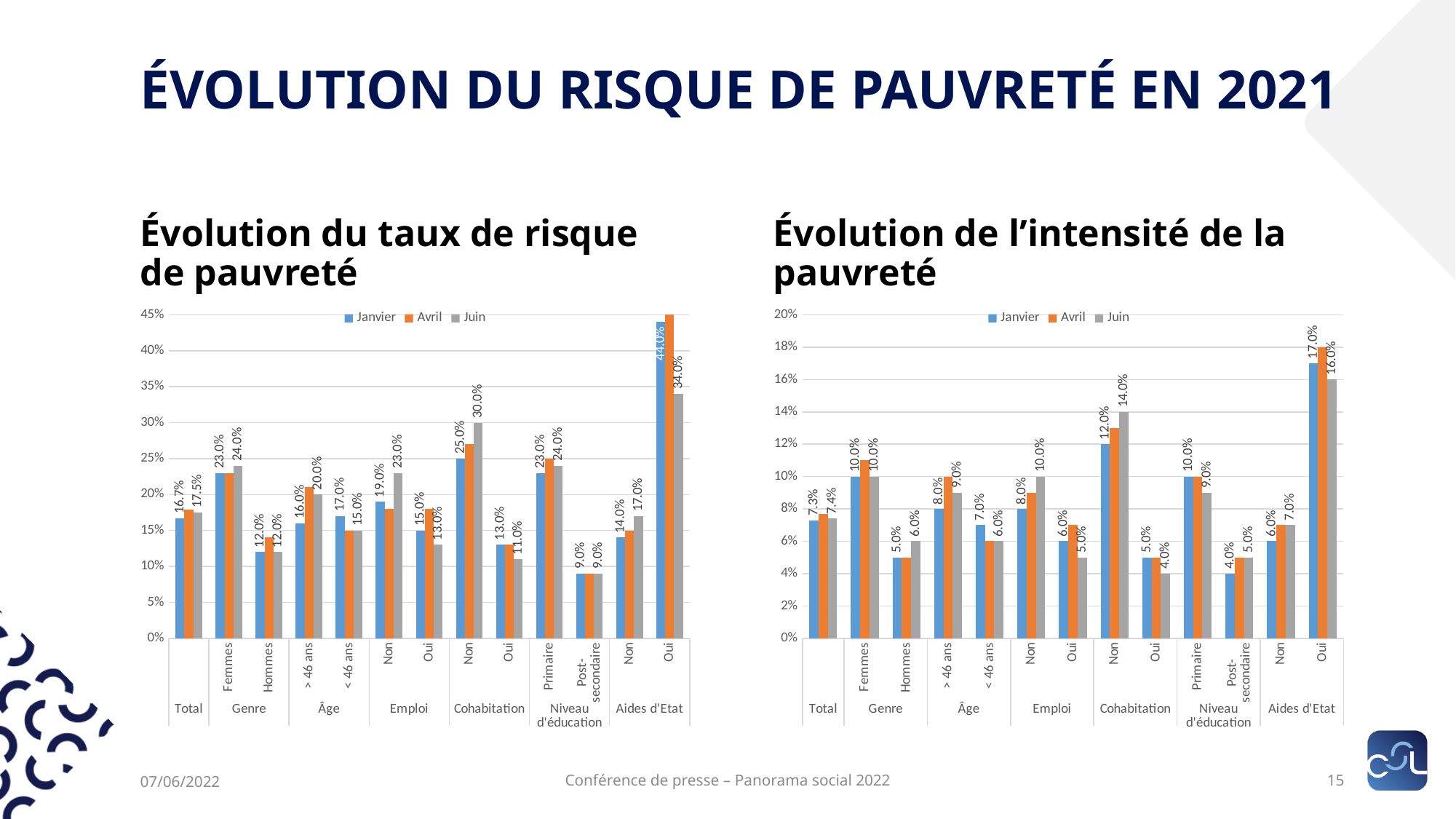
In the chart 'Évolution du taux de risque de pauvreté', which category has the highest Janvier value? Aides d'Etat Oui In the chart 'Évolution du taux de risque de pauvreté', what is the Janvier value for Total? 16.7% In the chart 'Évolution de l'intensité de la pauvreté', is the Avril value for Aides d'Etat Oui greater or less than 16%? greater In the chart 'Évolution de l'intensité de la pauvreté', what is the Janvier value for Total? 7.3% In the chart 'Évolution du taux de risque de pauvreté', how many series does the legend list? 3 In the chart 'Évolution du taux de risque de pauvreté', what is the Janvier value for Aides d'Etat Oui? 44.0% In the chart 'Évolution du taux de risque de pauvreté', what is the Juin value for Cohabitation Non? 30.0% In the chart 'Évolution de l'intensité de la pauvreté', what is the Juin value for Cohabitation Non? 14.0% In the chart 'Évolution de l'intensité de la pauvreté', is the Janvier value for Aides d'Etat Oui greater or less than the Juin value? greater In the chart 'Évolution de l'intensité de la pauvreté', which category has the lowest Janvier value? Post-secondaire In the chart 'Évolution du taux de risque de pauvreté', what is the difference between the Janvier and Juin values for Aides d'Etat Oui? 10.0% What kind of chart is 'Évolution de l'intensité de la pauvreté'? Bar chart